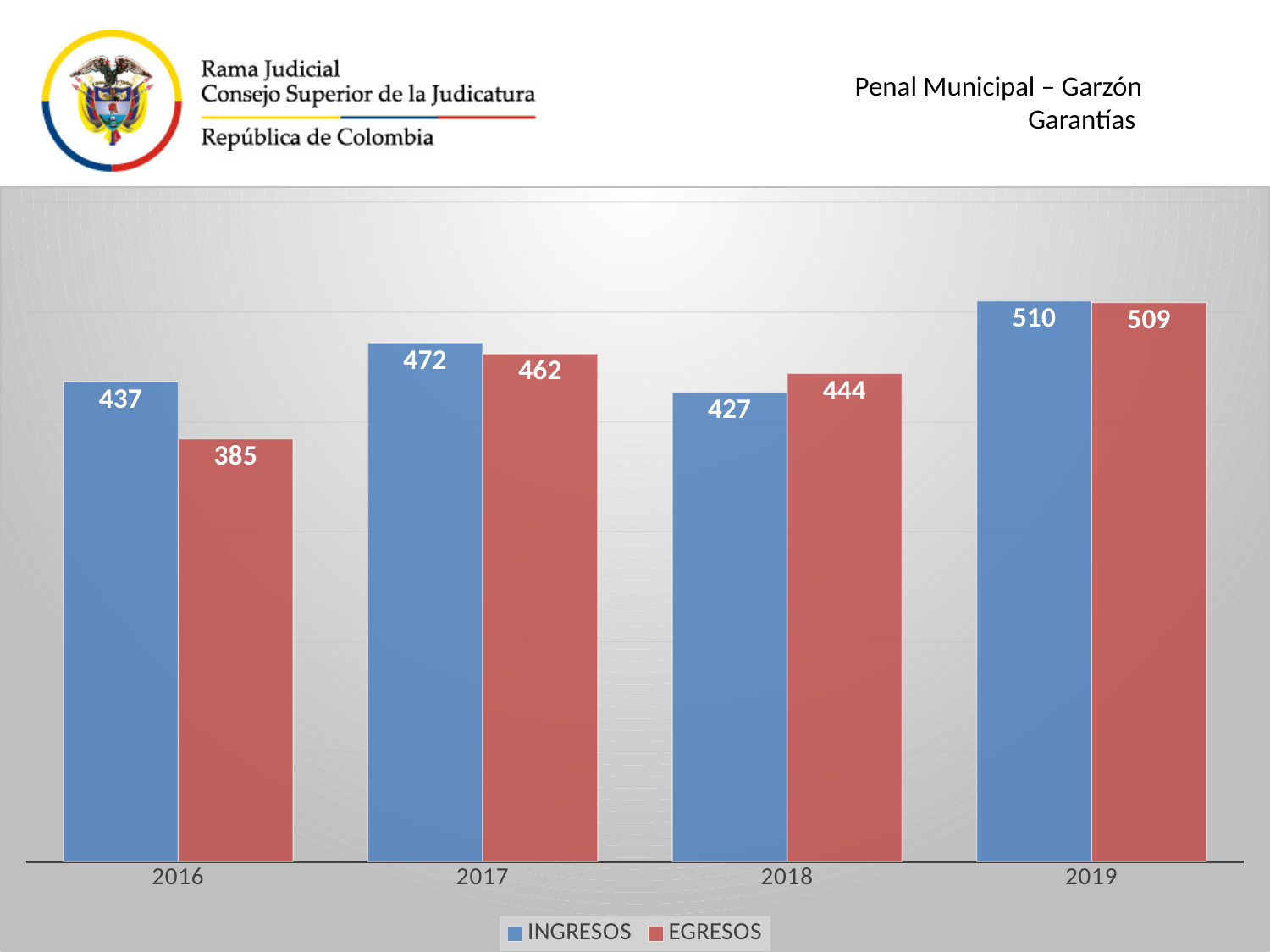
What kind of chart is shown on the slide? Bar chart What is the INGRESOS value for 2016? 437 In 2018, which is larger, INGRESOS or EGRESOS? EGRESOS Which year has the highest INGRESOS value? 2019 Which series is shown in red in the legend? EGRESOS What is the EGRESOS value for 2017? 462 How many years are shown on the x axis? 4 What is the EGRESOS value for 2018? 444 What is the difference between INGRESOS in 2019 and INGRESOS in 2018? 83 What is the difference between INGRESOS and EGRESOS in 2016? 52 Which year has the lowest EGRESOS value? 2016 How many series does the legend list? 2